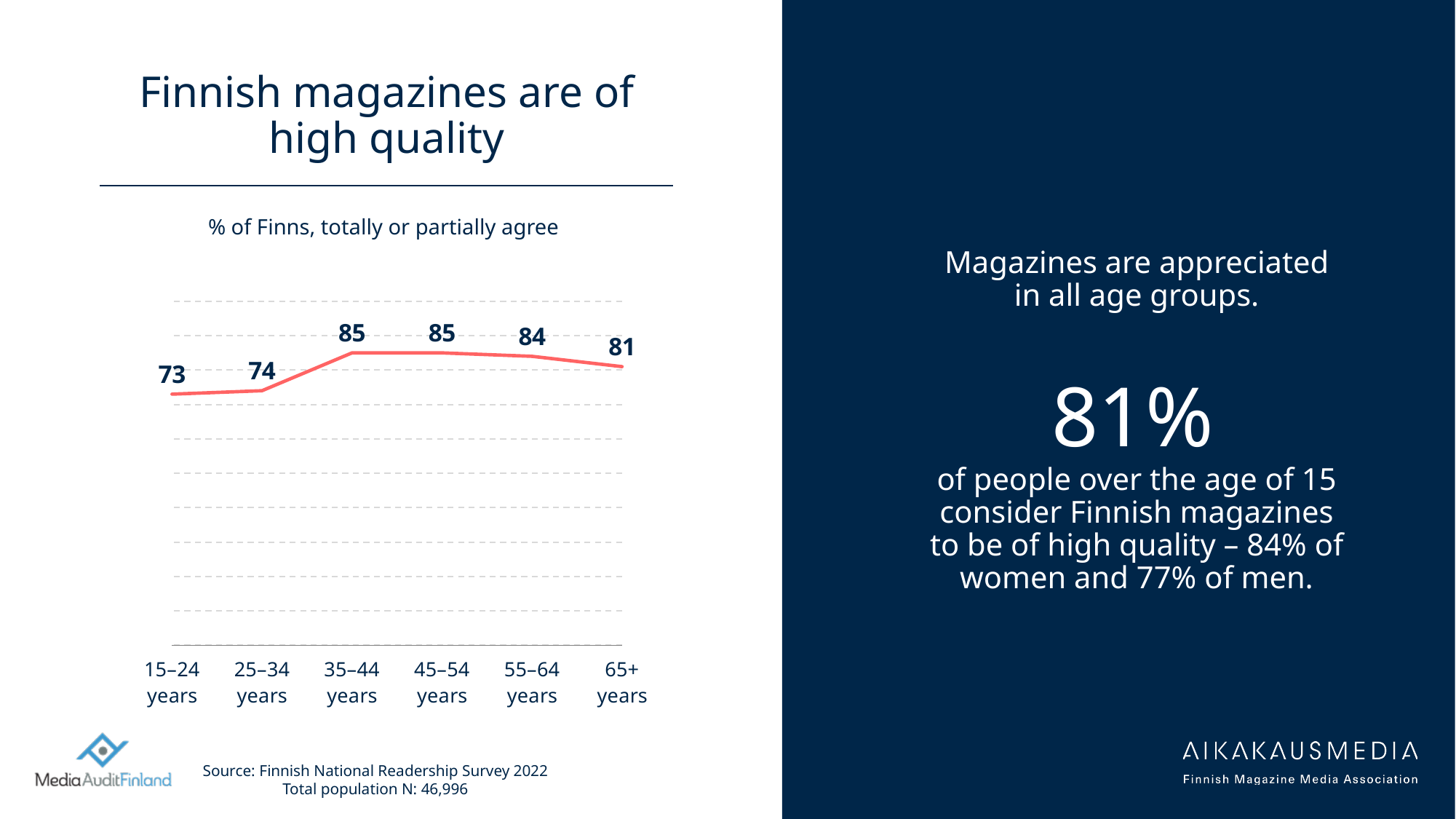
What is the value for the 65+ years age group? 81 How many age groups are plotted on the chart? 6 Do the values rise or fall from 15–24 years to 35–44 years? rise What is the subtitle shown above the chart? % of Finns, totally or partially agree What is the value for the 55–64 years age group? 84 What is the value for the 15–24 years age group? 73 Do the values rise or fall from 45–54 years to 65+ years? fall Which is larger, the value for 25–34 years or the value for 65+ years? 65+ years Which age group has the lowest value? 15–24 years What kind of chart is shown on the slide? line chart What is the difference between the values for 55–64 years and 65+ years? 3 What is the difference between the values for 35–44 years and 15–24 years? 12